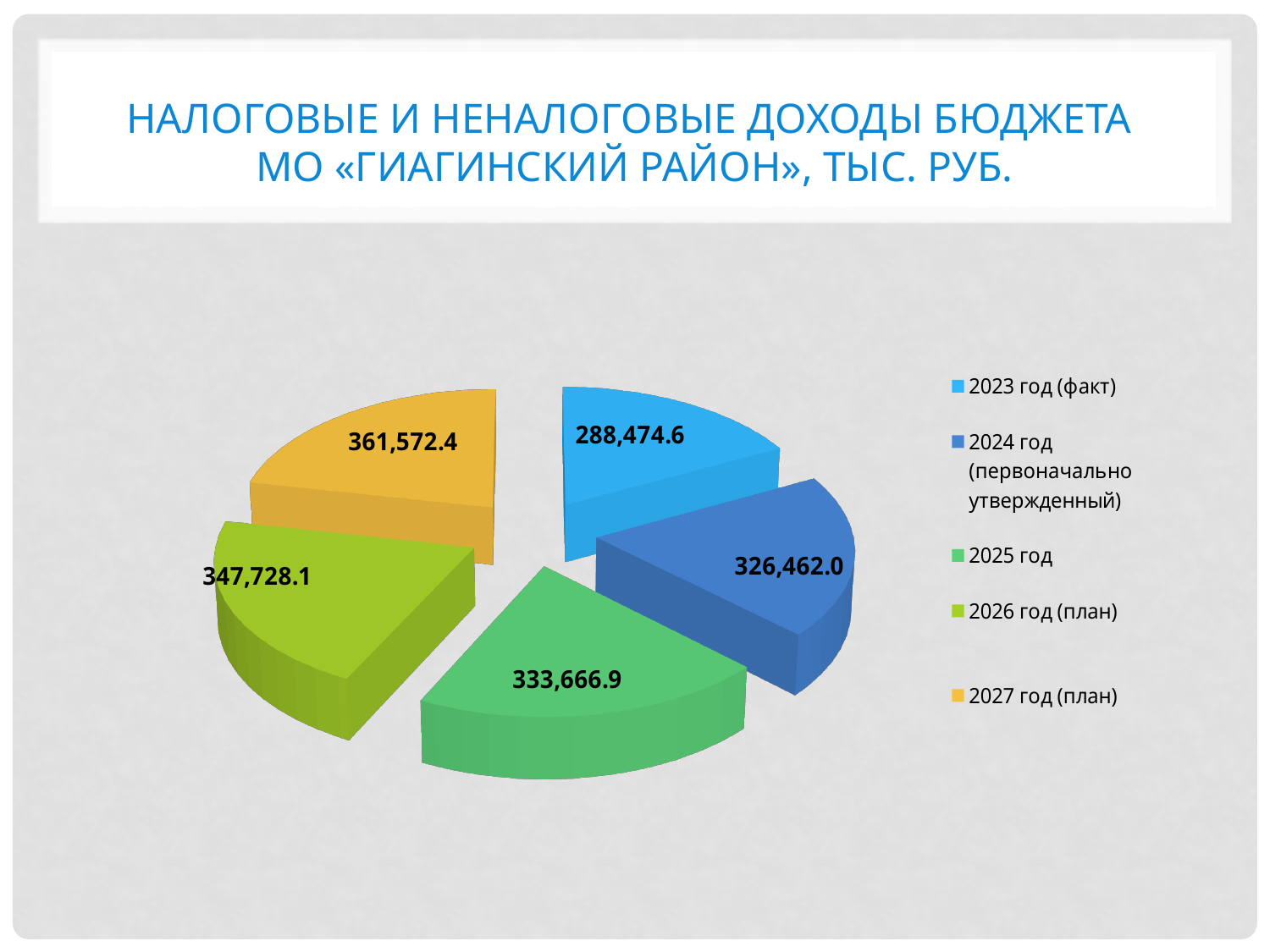
Which is larger, the value for 2024 год (первоначально утвержденный) or the value for 2025 год? 2025 год What is the value for 2027 год (план)? 361,572.4 How many slices does the pie chart have? 5 What is the value for 2024 год (первоначально утвержденный)? 326,462.0 Which year has the smallest slice? 2023 год (факт) What is the value for 2025 год? 333,666.9 What is the value for 2023 год (факт)? 288,474.6 Do the values rise or fall from 2023 to 2027? rise What is the difference between the values for 2026 год (план) and 2025 год? 14,061.2 What is the difference between the values for 2027 год (план) and 2023 год (факт)? 73,097.8 Which year has the largest slice? 2027 год (план) What type of chart is shown on the slide? pie chart